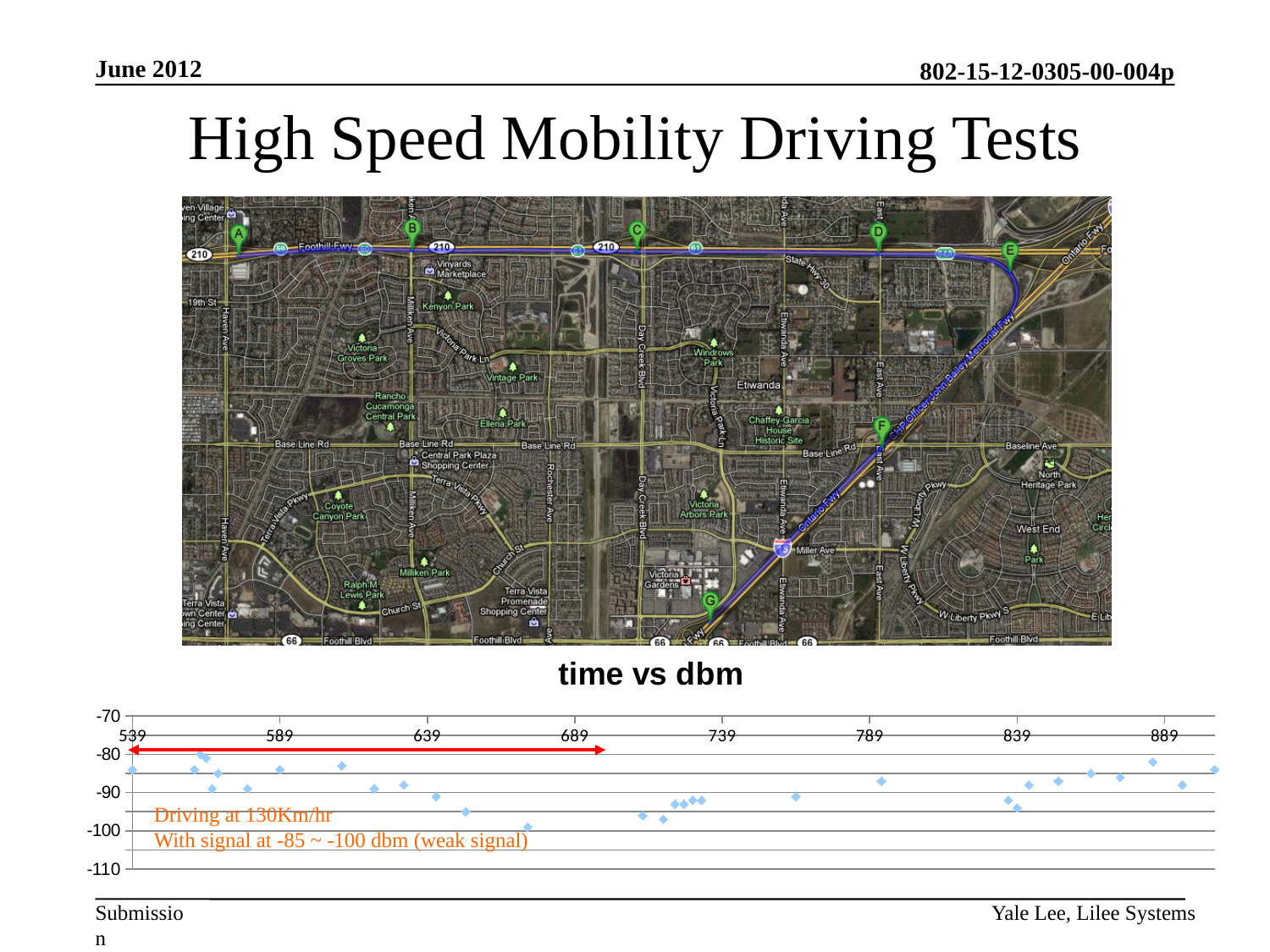
What is the highest value labelled on the y axis of the chart? -70 Are the plotted points near x = 739 greater or less than -90? less What is the first tick label on the x axis of the chart? 539 Are any plotted points in the chart above -70? No Are the plotted points near x = 889 greater or less than -90? greater What is the last tick label on the x axis of the chart? 889 What is the lowest value labelled on the y axis of the chart? -110 What is the title of the chart on the slide? time vs dbm What kind of chart is shown on the slide? scatter chart How many tick labels are shown on the x axis of the chart? 8